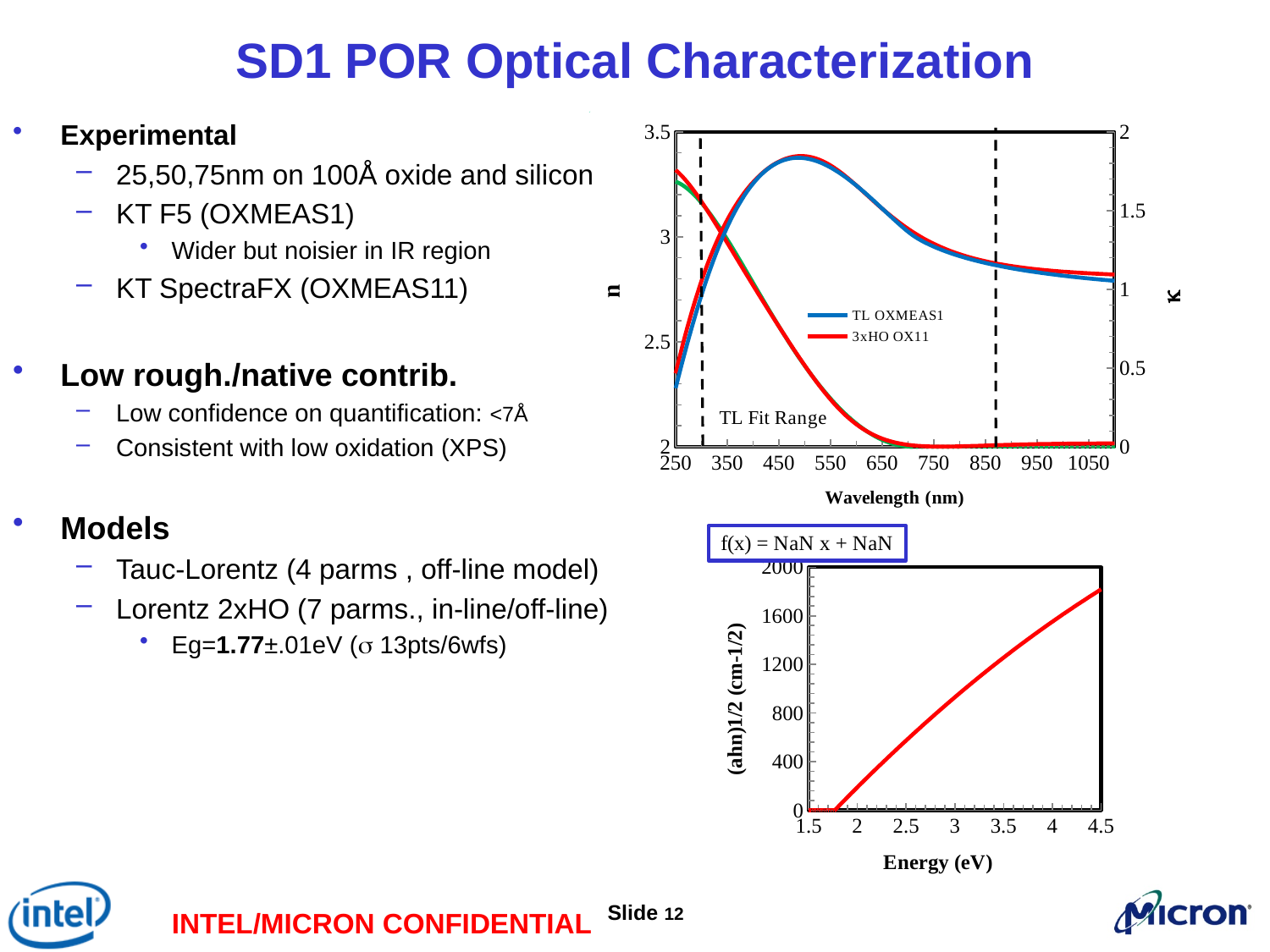
What kind of chart is the bottom chart on the slide? line chart In the top chart, does κ (right axis) rise or fall as wavelength increases from 350 nm to 750 nm? fall What is the x-axis label of the top chart? Wavelength (nm) In the bottom chart, does the plotted value rise or fall as Energy (eV) increases? rise In the bottom chart, is the value at 4.5 eV greater or less than 1600? greater In the bottom chart, is the value at 4 eV greater or less than 1200? greater What are the two series named in the legend of the top chart? TL OXMEAS1 and 3xHO OX11 What kind of chart is the top chart on the slide? line chart In the top chart, is the peak value of n (left axis) greater or less than 3? greater How many series does the legend of the top chart list? 2